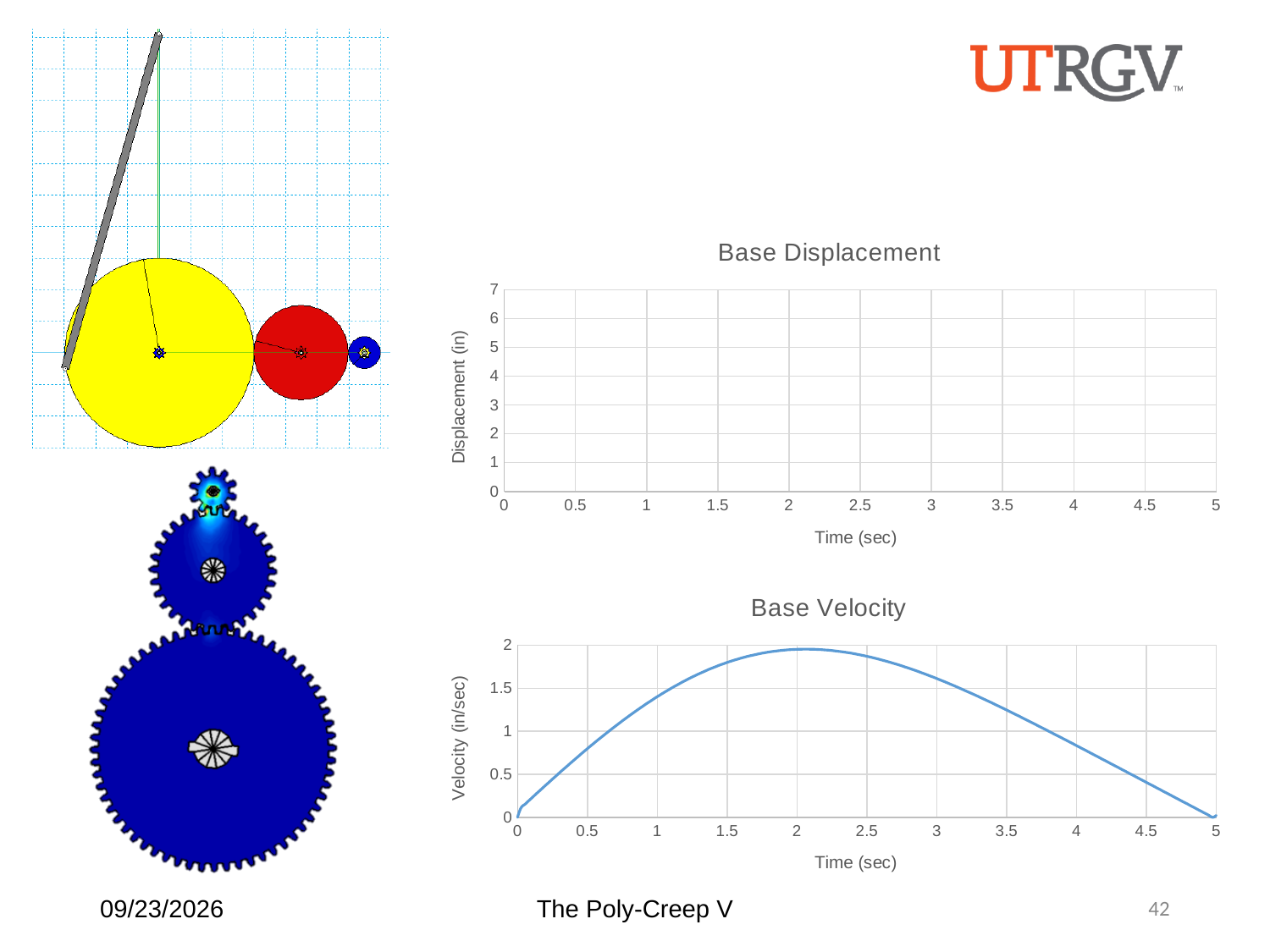
What kind of chart is the Base Velocity chart? line chart What is the title of the upper chart on the slide? Base Displacement In the Base Velocity chart, is the velocity at 0.5 seconds greater or less than 0.5? greater In the Base Velocity chart, is the velocity at 4 seconds greater or less than 1.5? less In the Base Velocity chart, how does the velocity change between 2 seconds and 5 seconds? it falls In the Base Velocity chart, is the velocity at 1 second greater or less than 1? greater What is the y-axis label of the Base Velocity chart? Velocity (in/sec) In the Base Velocity chart, how does the velocity change between 0 and 2 seconds? it rises In the Base Velocity chart, which is larger: the velocity at 2 seconds or the velocity at 4.5 seconds? 2 seconds